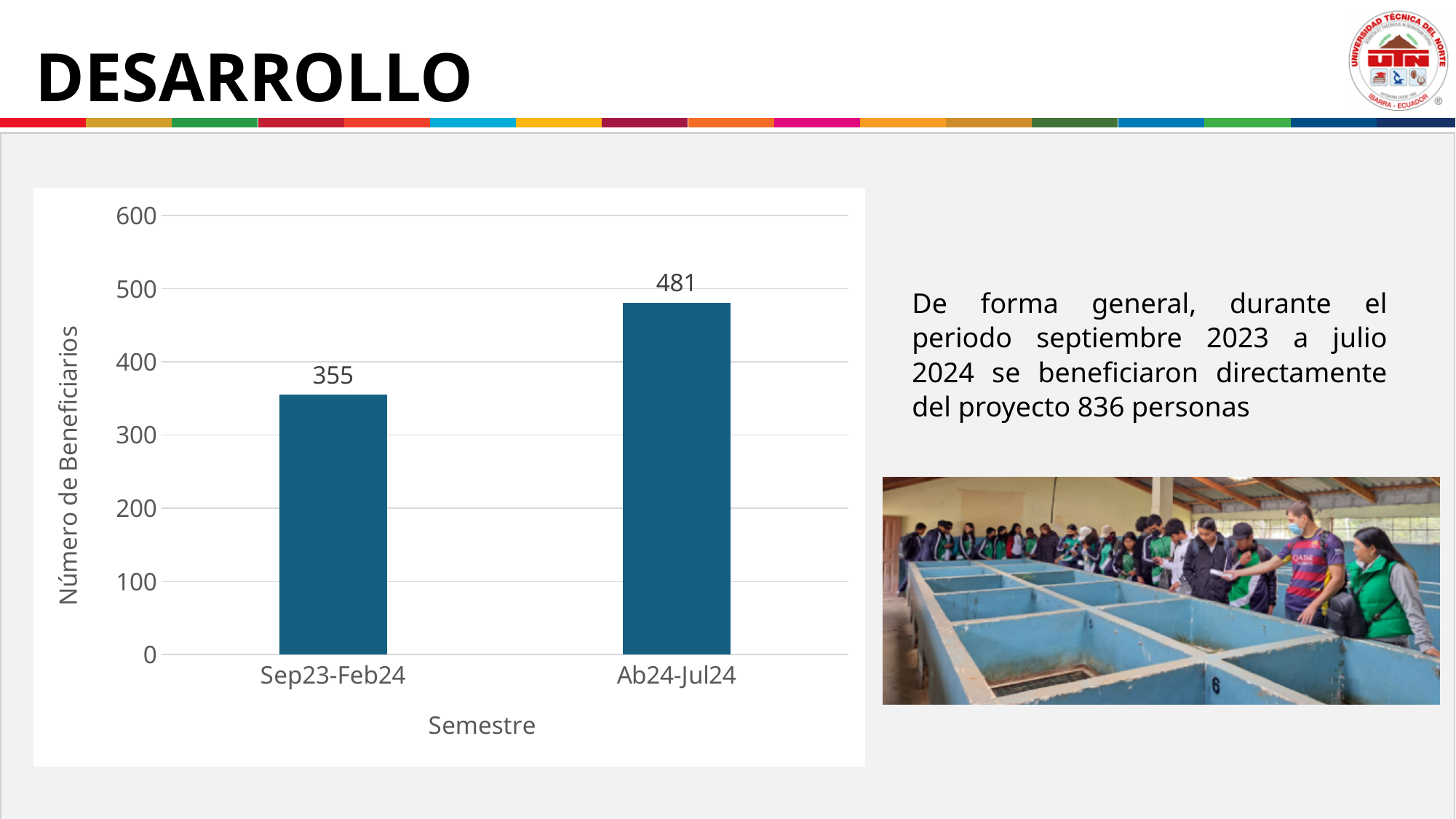
Which semester has the lowest number of beneficiaries? Sep23-Feb24 How many semesters are shown on the chart? 2 What is the number of beneficiaries for Sep23-Feb24? 355 What is the difference in beneficiaries between Ab24-Jul24 and Sep23-Feb24? 126 Which semester has the highest number of beneficiaries? Ab24-Jul24 Is the value for Ab24-Jul24 greater or less than 400? greater What kind of chart is shown on the slide? bar chart What is the number of beneficiaries for Ab24-Jul24? 481 Is the value for Sep23-Feb24 greater or less than 400? less What is the label of the vertical axis of the chart? Número de Beneficiarios Which has more beneficiaries, Sep23-Feb24 or Ab24-Jul24? Ab24-Jul24 Do the values rise or fall from Sep23-Feb24 to Ab24-Jul24? rise